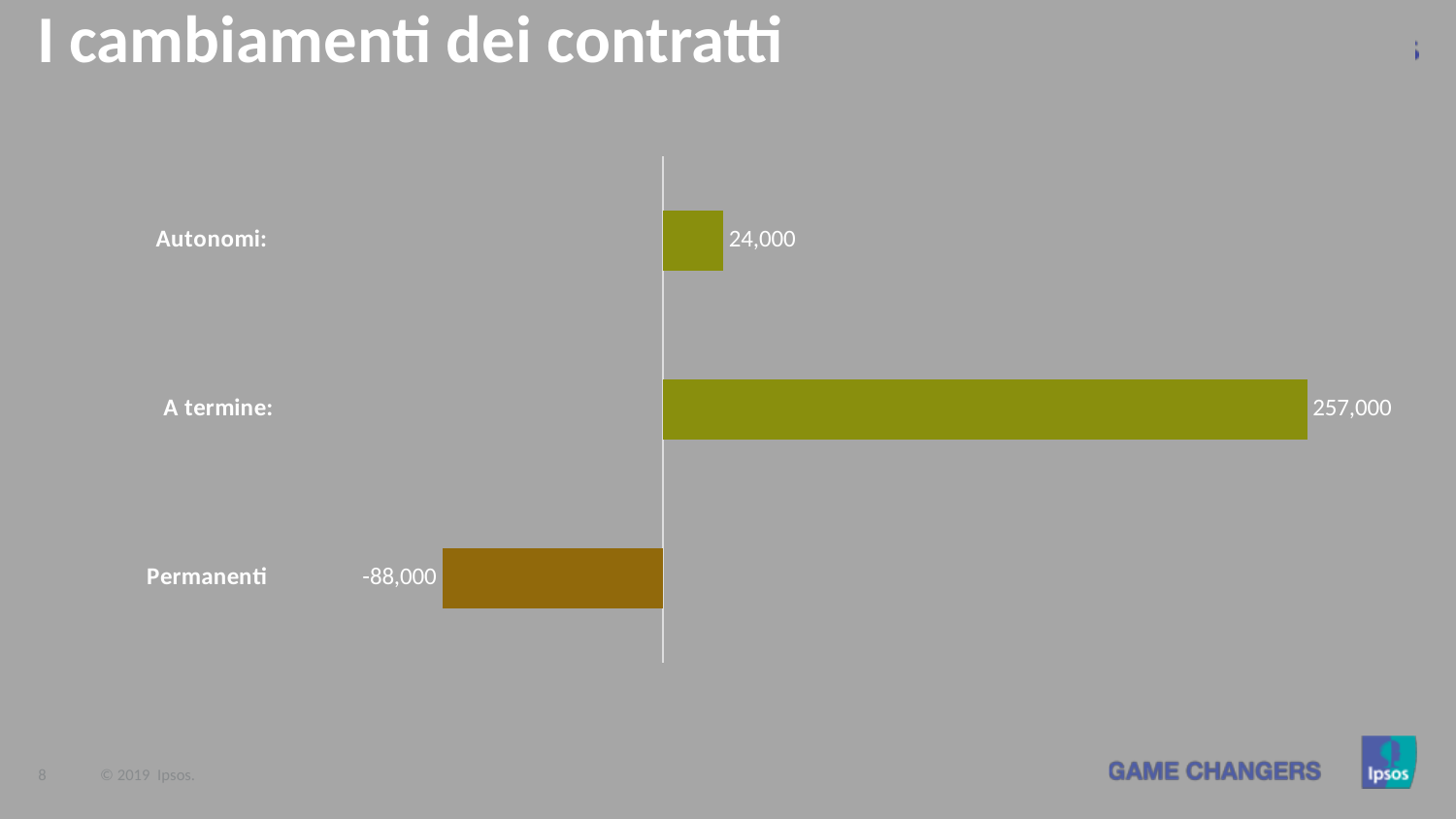
What is the value for Permanenti? -88,000 What is the value for Autonomi? 24,000 What is the value for A termine? 257,000 Which category has the lowest value? Permanenti Which is larger, the value for Autonomi or the value for A termine? A termine How many categories are shown in the chart? 3 What kind of chart is shown on the slide? Bar chart What is the difference between the values for Autonomi and Permanenti? 112,000 What is the difference between the values for A termine and Autonomi? 233,000 Which category has the highest value? A termine Which category has a negative value? Permanenti What is the title of the slide? I cambiamenti dei contratti